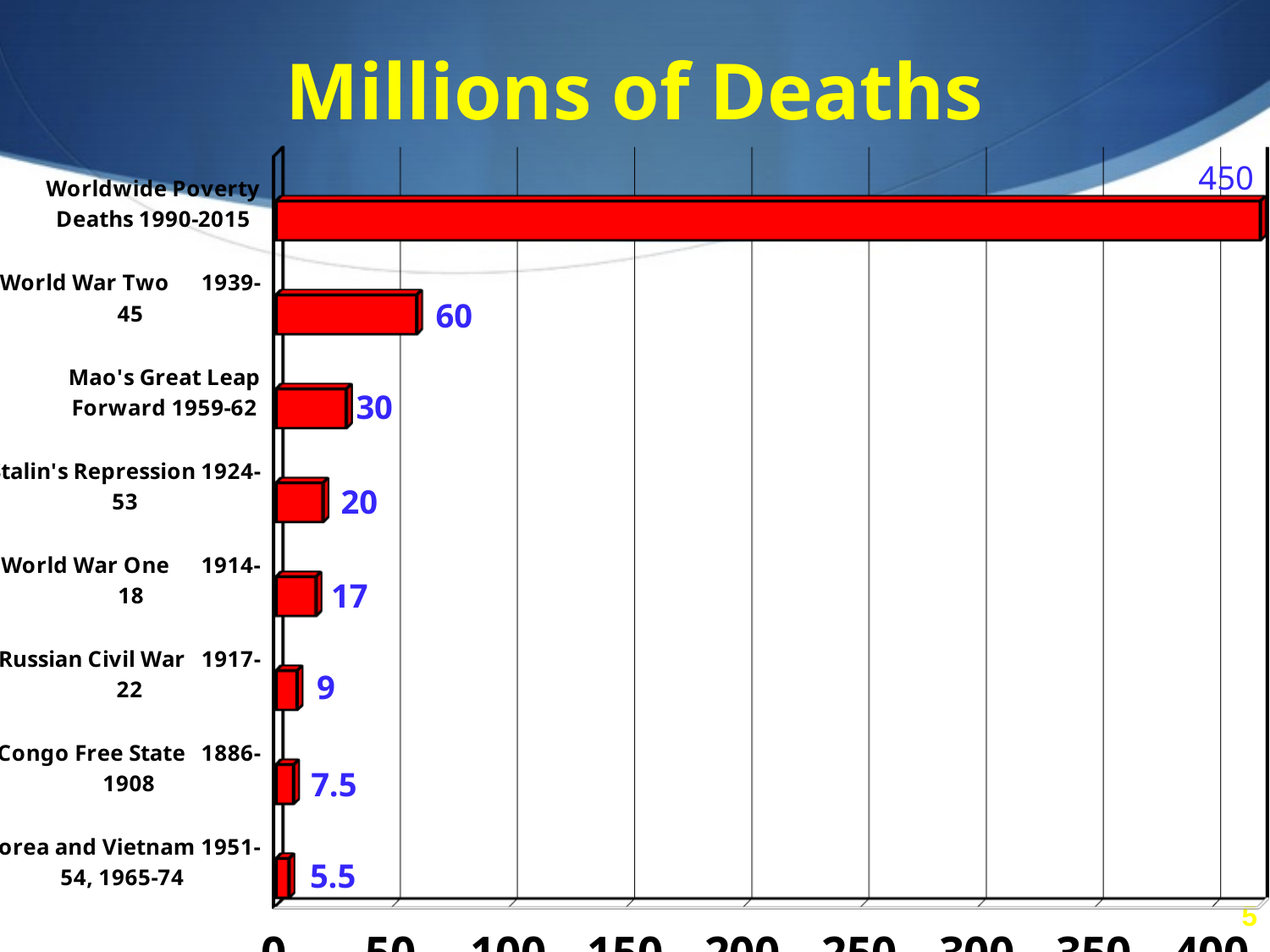
What is the title of the chart? Millions of Deaths What is the value for Worldwide Poverty Deaths 1990-2015? 450 What is the value for World War Two 1939-45? 60 Which category has the highest value? Worldwide Poverty Deaths 1990-2015 Which category has the lowest value? Korea and Vietnam 1951-54, 1965-74 How many categories are shown in the chart? 8 What is the difference between the values for World War Two 1939-45 and World War One 1914-18? 43 What is the value for Congo Free State 1886-1908? 7.5 What kind of chart is shown on the slide? bar chart What is the value for Mao's Great Leap Forward 1959-62? 30 Is the value for World War Two 1939-45 greater or less than 50? greater Which is larger, the value for Russian Civil War 1917-22 or Congo Free State 1886-1908? Russian Civil War 1917-22